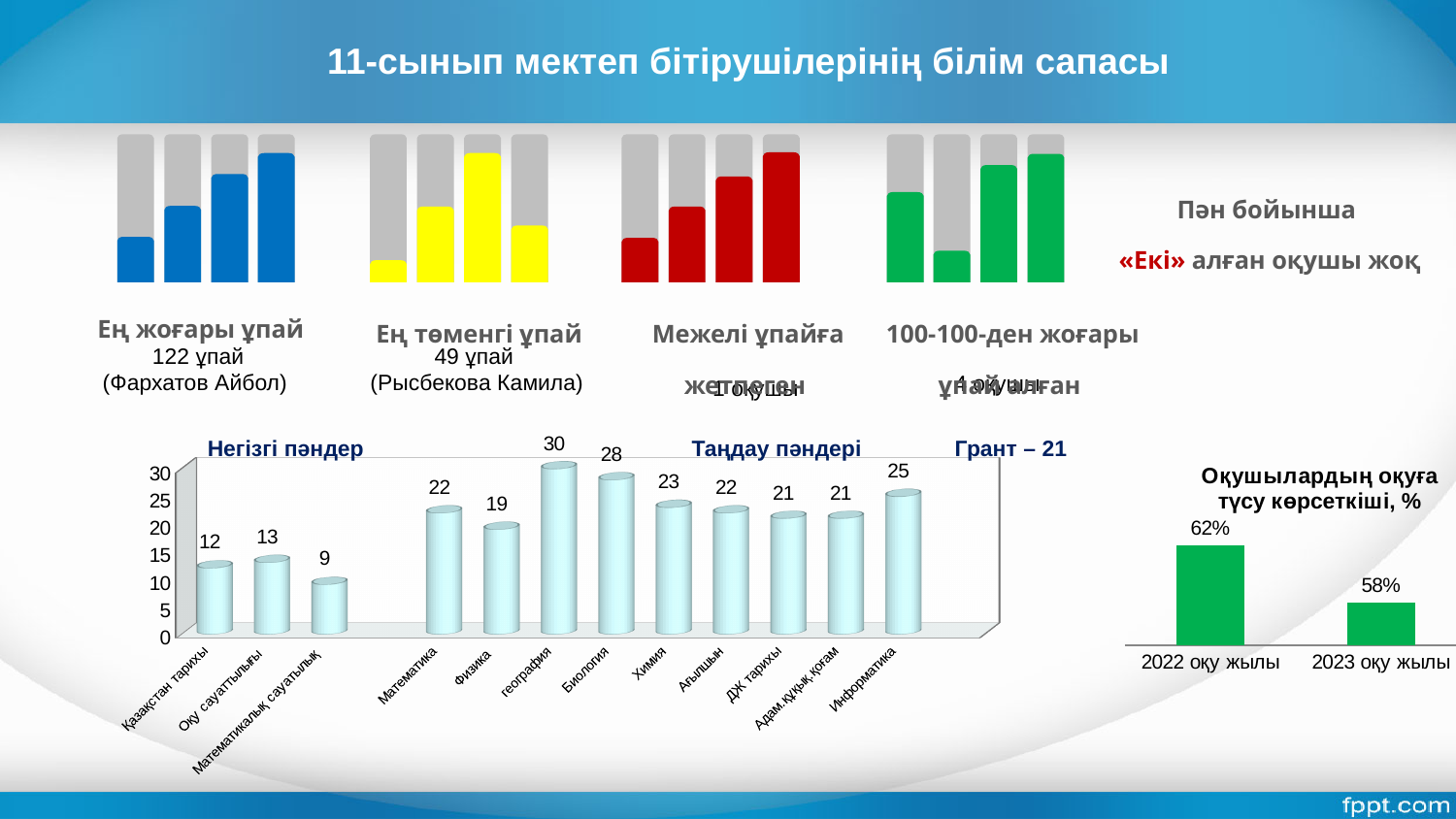
In the large bar chart at the bottom left, what is the difference between the values for география and Биология? 2 In the large bar chart at the bottom left, what is the value for Информатика? 25 In the chart titled 'Оқушылардың оқуға түсу көрсеткіші, %', do the values rise or fall from 2022 to 2023? fall In the large bar chart at the bottom left, what is the value for Физика? 19 In the chart titled 'Оқушылардың оқуға түсу көрсеткіші, %', what is the difference between the values for 2022 оқу жылы and 2023 оқу жылы? 4% In the large bar chart at the bottom left, which is larger, the value for Математика or the value for Физика? Математика How many categories are shown in the large bar chart at the bottom left? 12 In the chart titled 'Оқушылардың оқуға түсу көрсеткіші, %', what is the value for 2022 оқу жылы? 62% In the large bar chart at the bottom left, which category has the highest value? география In the large bar chart at the bottom left, which category has the lowest value? Математикалық сауаттылық What kind of chart is the large chart at the bottom left? bar chart In the large bar chart at the bottom left, what is the value for география? 30